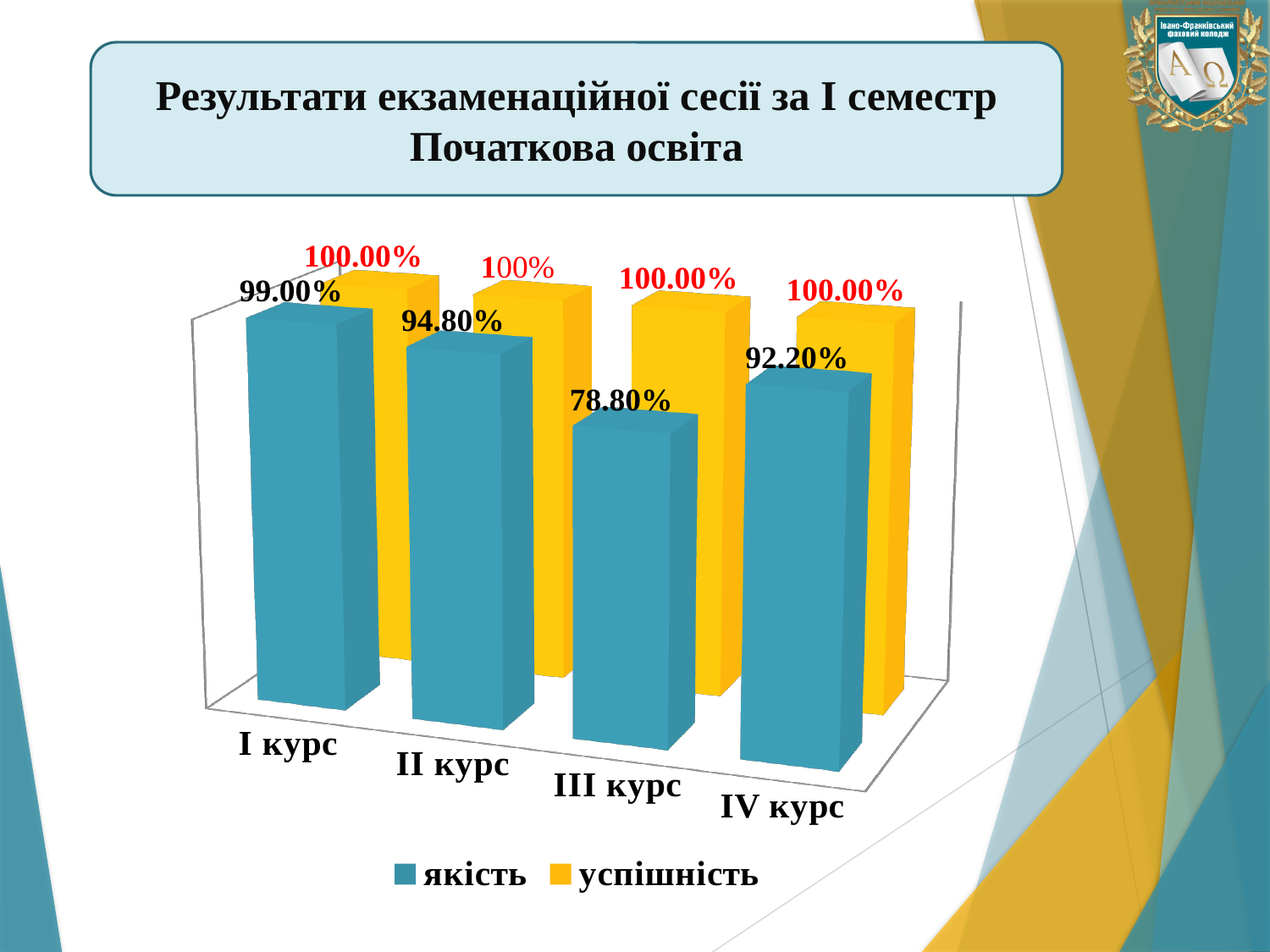
What is the difference between the якість values for II курс and IV курс? 2.60% What is the якість value for III курс? 78.80% What kind of chart is shown on the slide? Bar chart What is the успішність value for III курс? 100.00% Which course has the lowest якість value? III курс Which is larger, the якість value for II курс or for IV курс? II курс How many courses (categories) are shown on the chart? 4 What is the якість value for IV курс? 92.20% What is the difference between the якість values for I курс and III курс? 20.20% How many series does the legend list? 2 What is the якість value for I курс? 99.00% Which course has the highest якість value? I курс